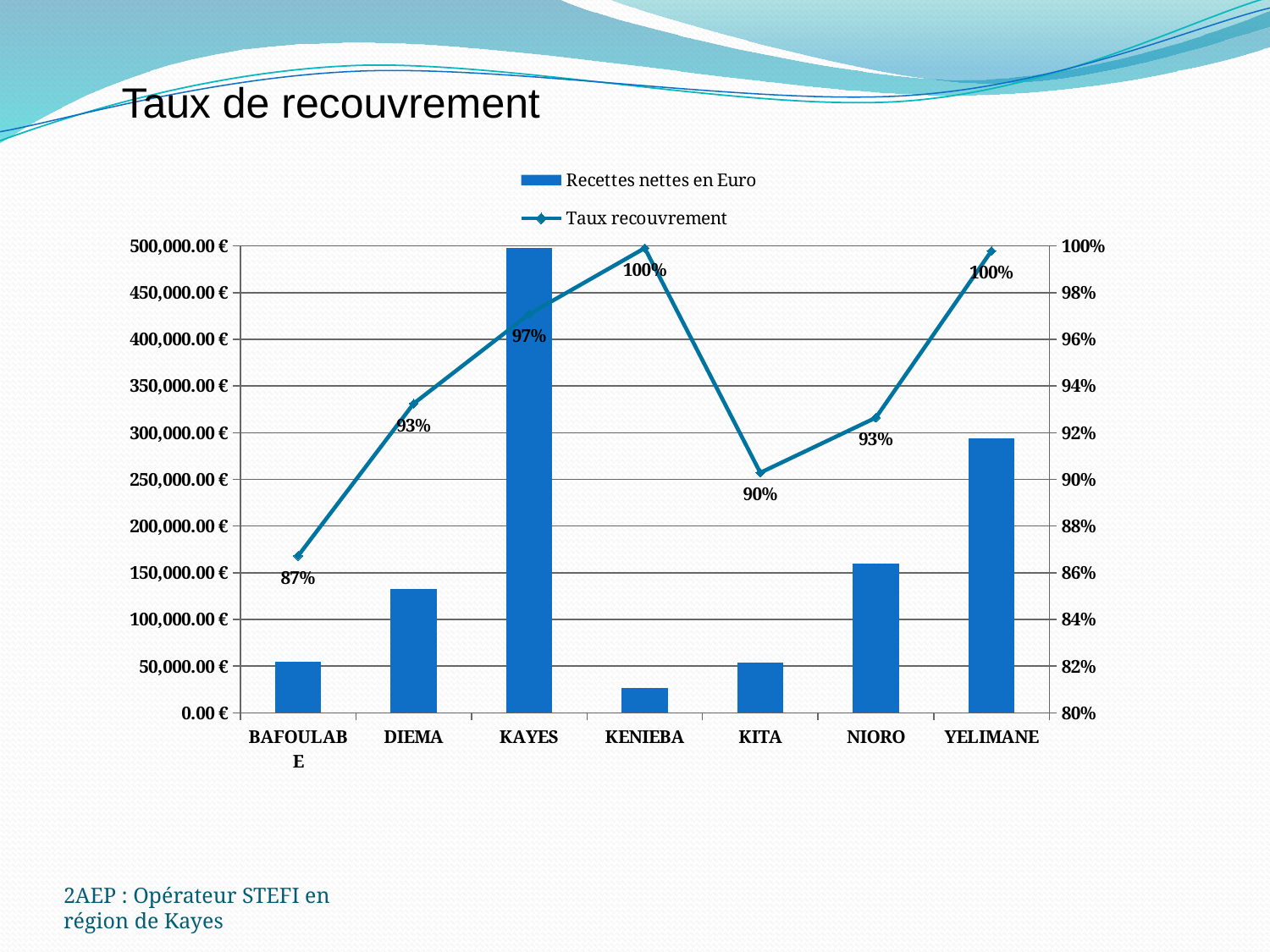
Is the Recettes nettes en Euro bar for YELIMANE greater or less than 250,000.00 €? greater What is the Taux recouvrement value for KAYES? 97% Which category has the highest Recettes nettes en Euro bar? KAYES Which has a higher Recettes nettes en Euro bar, DIEMA or NIORO? NIORO Is the Recettes nettes en Euro bar for NIORO greater or less than 200,000.00 €? less What is the Taux recouvrement value for KITA? 90% How many series does the legend list? 2 What is the Taux recouvrement value for BAFOULABE? 87% How many categories are shown on the x axis? 7 Which category has the lowest Recettes nettes en Euro bar? KENIEBA What is the difference in Taux recouvrement between KENIEBA and KITA? 10% Which category has the lowest Taux recouvrement? BAFOULABE